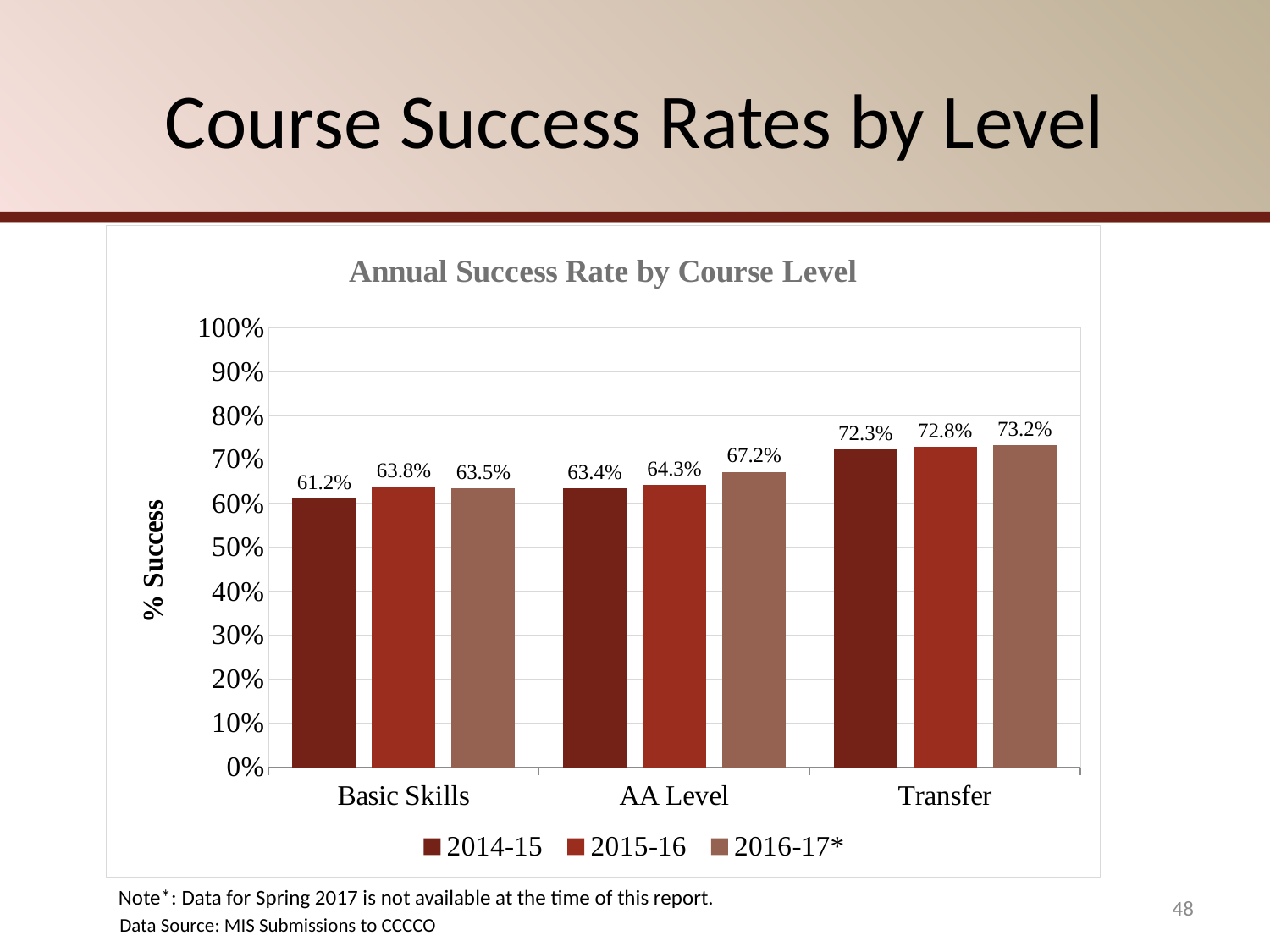
Which course level has the highest success rate in 2015-16? Transfer Which is larger: the AA Level success rate in 2016-17* or the Basic Skills success rate in 2016-17*? AA Level What is the success rate for Transfer in 2016-17*? 73.2% How many course levels are shown on the x axis? 3 Which course level has the lowest success rate in 2014-15? Basic Skills What is the success rate for AA Level in 2015-16? 64.3% What kind of chart is shown on the slide? bar chart What is the title of the chart? Annual Success Rate by Course Level How many series does the legend list? 3 What is the success rate for Basic Skills in 2014-15? 61.2% What is the difference between the Transfer and Basic Skills success rates in 2016-17*? 9.7% Is the success rate for Transfer in 2014-15 greater or less than 70%? greater